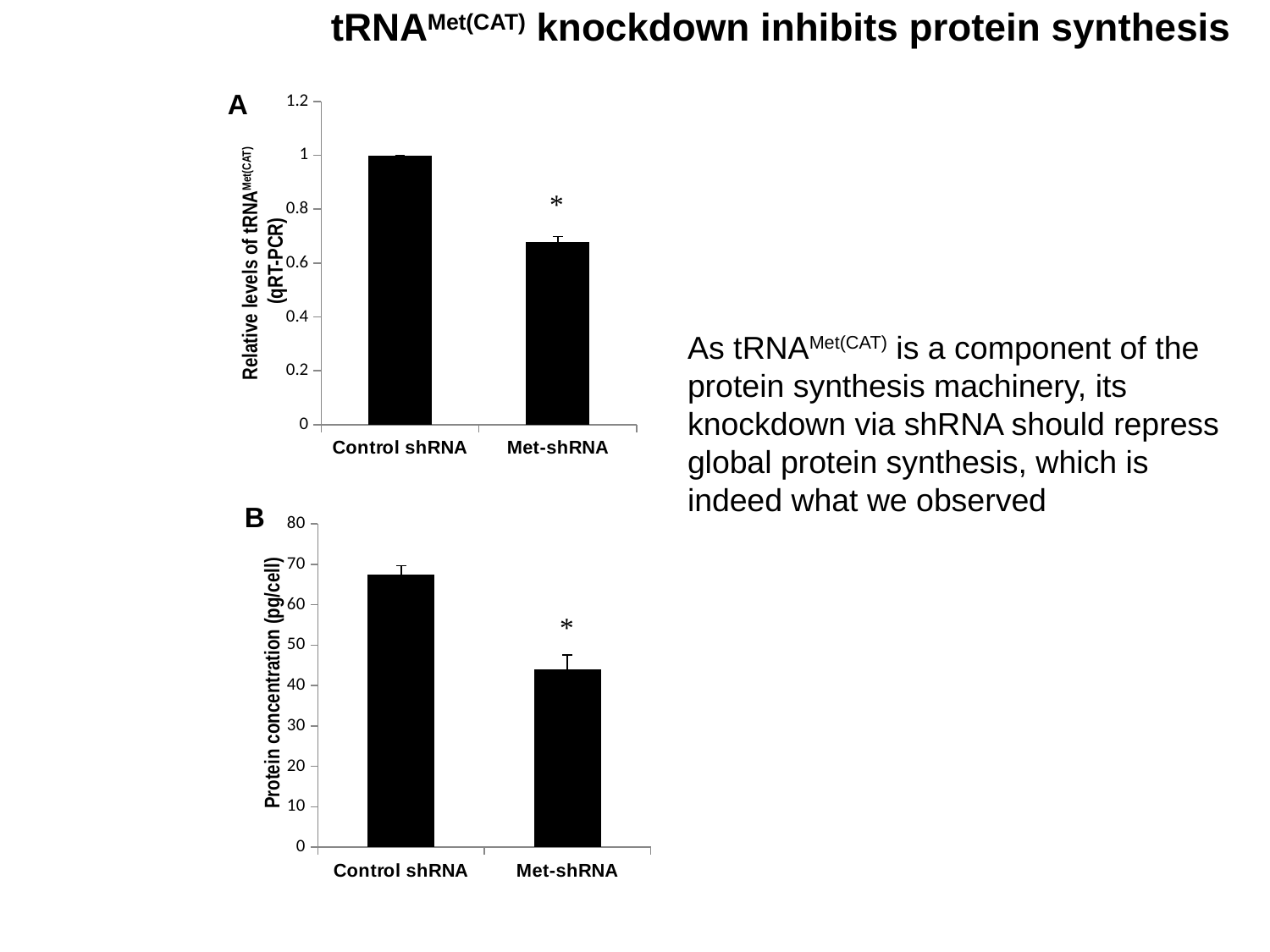
In chart B (the bottom chart), which is larger, the value for Control shRNA or the value for Met-shRNA? Control shRNA In chart A (the top chart), is the value for Met-shRNA greater or less than 0.8? less In chart A (the top chart), what is the value for Control shRNA? 1 In chart B (the bottom chart), is the value for Met-shRNA greater or less than 50? less In chart A (the top chart), is the value for Met-shRNA greater or less than 0.6? greater In chart B (the bottom chart), which category has the lowest bar? Met-shRNA How many categories are shown on the x axis of chart B (the bottom chart)? 2 In chart A (the top chart), which category has the highest bar? Control shRNA What kind of chart is chart A (the top chart)? bar chart What is the y-axis label of chart B (the bottom chart)? Protein concentration (pg/cell) Do the values in chart B (the bottom chart) rise or fall from Control shRNA to Met-shRNA? fall